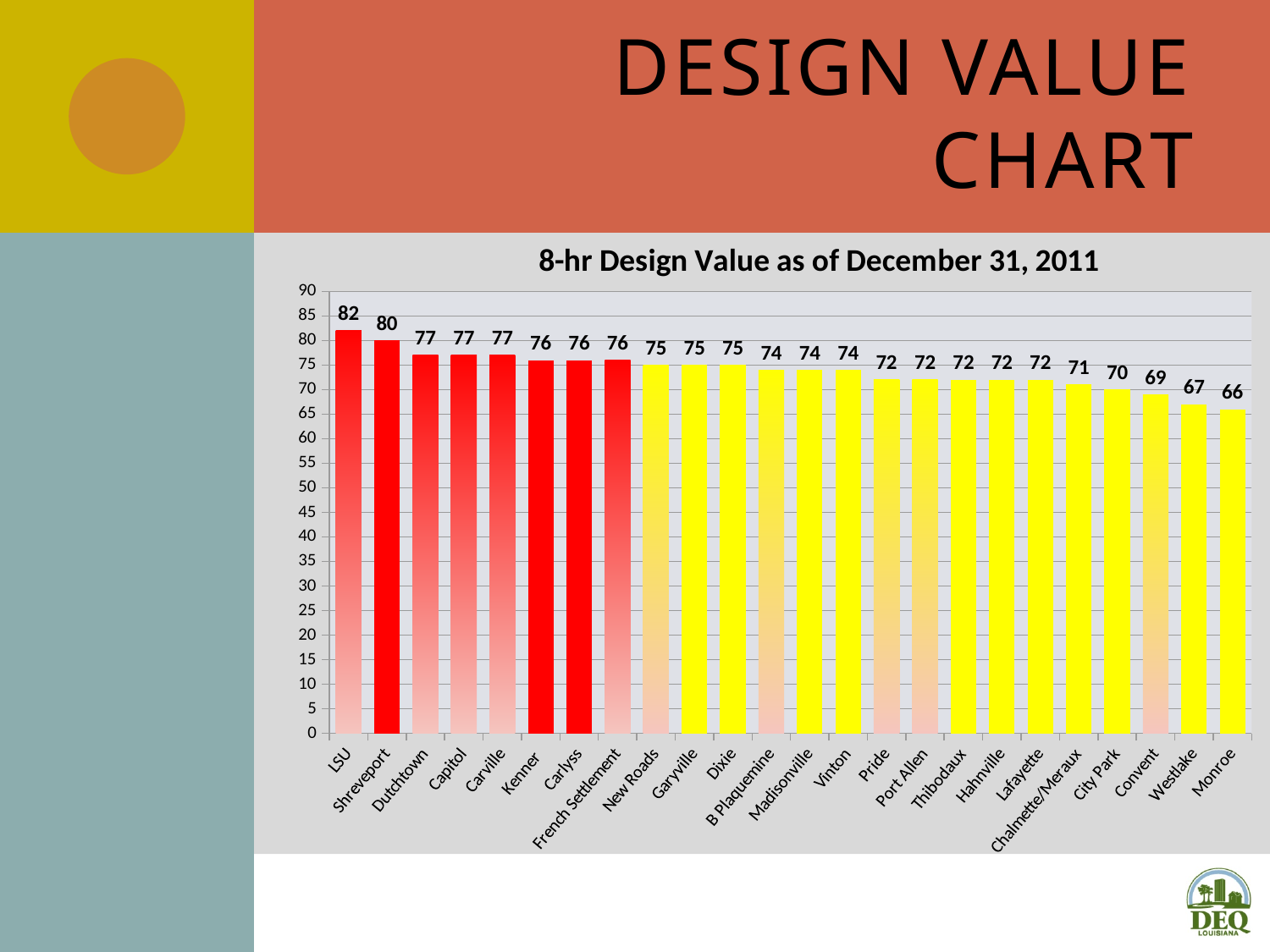
What is the 8-hr design value for Chalmette/Meraux? 71 Which site has the lowest 8-hr design value? Monroe What is the 8-hr design value for Monroe? 66 What is the title of the chart? 8-hr Design Value as of December 31, 2011 How many sites are shown on the chart? 24 Is the design value for Convent greater or less than 75? less Which site has the highest 8-hr design value? LSU What is the difference between the design values for Kenner and Westlake? 9 What is the difference between the design values for LSU and Shreveport? 2 What type of chart is shown on the slide? Bar chart Which has a higher design value, Vinton or City Park? Vinton What is the 8-hr design value for LSU? 82